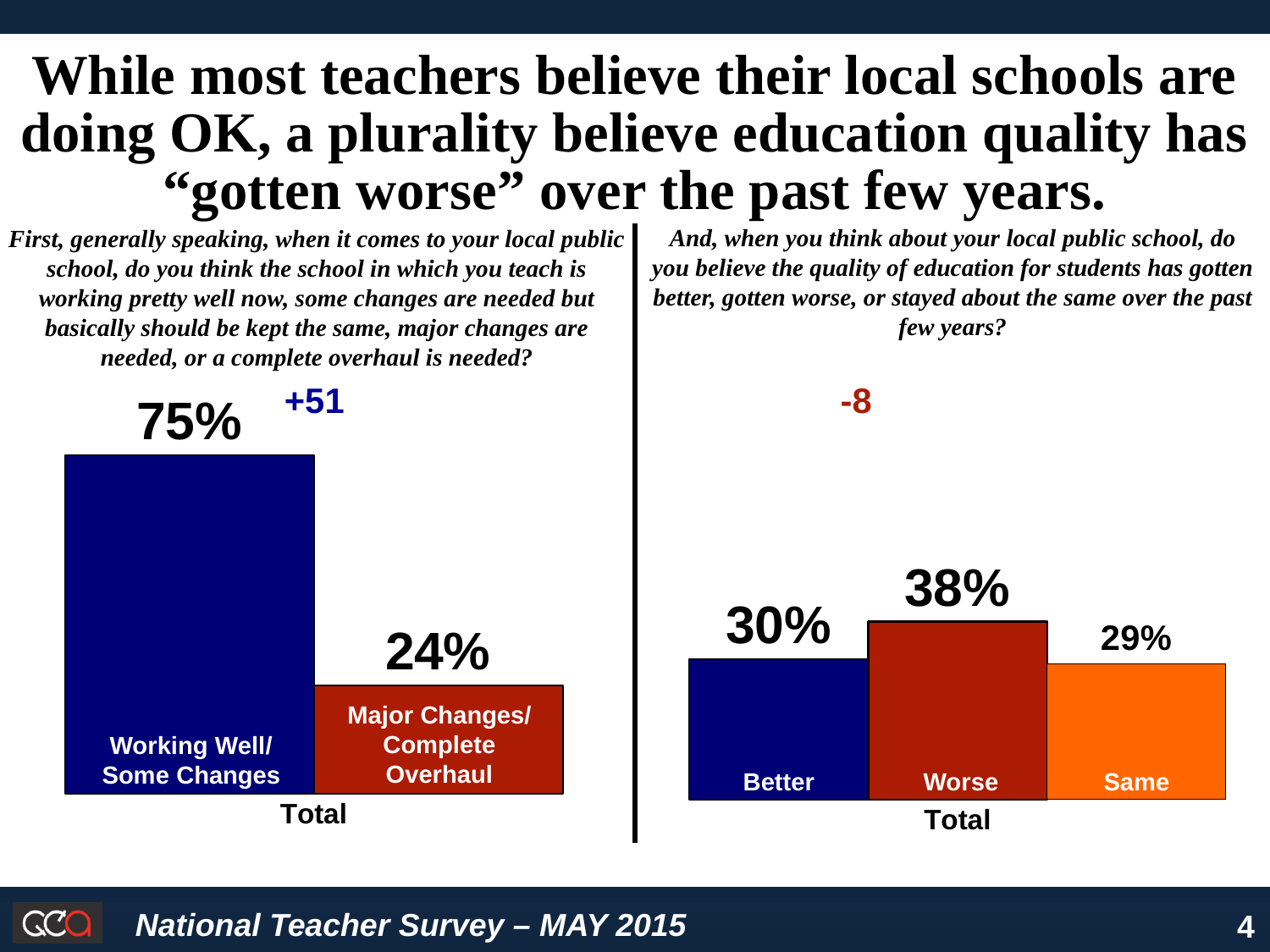
In the right chart, how many response categories are shown? 3 In the right chart, what is the difference between Worse and Better? 8 In the right chart, what percentage of teachers said education quality has gotten Better? 30% In the left chart, how many bars are plotted? 2 In the right chart, what colour is the Worse bar? Red In the left chart, what percentage of teachers said Major Changes/Complete Overhaul? 24% In the left chart, what percentage of teachers said their school is Working Well/Some Changes? 75% What kind of chart is the right chart? Bar chart In the right chart, what percentage of teachers said education quality has gotten Worse? 38% In the right chart, what percentage of teachers said education quality stayed the Same? 29% In the left chart, what is the difference between Working Well/Some Changes and Major Changes/Complete Overhaul? 51 In the right chart, which response has the highest value? Worse